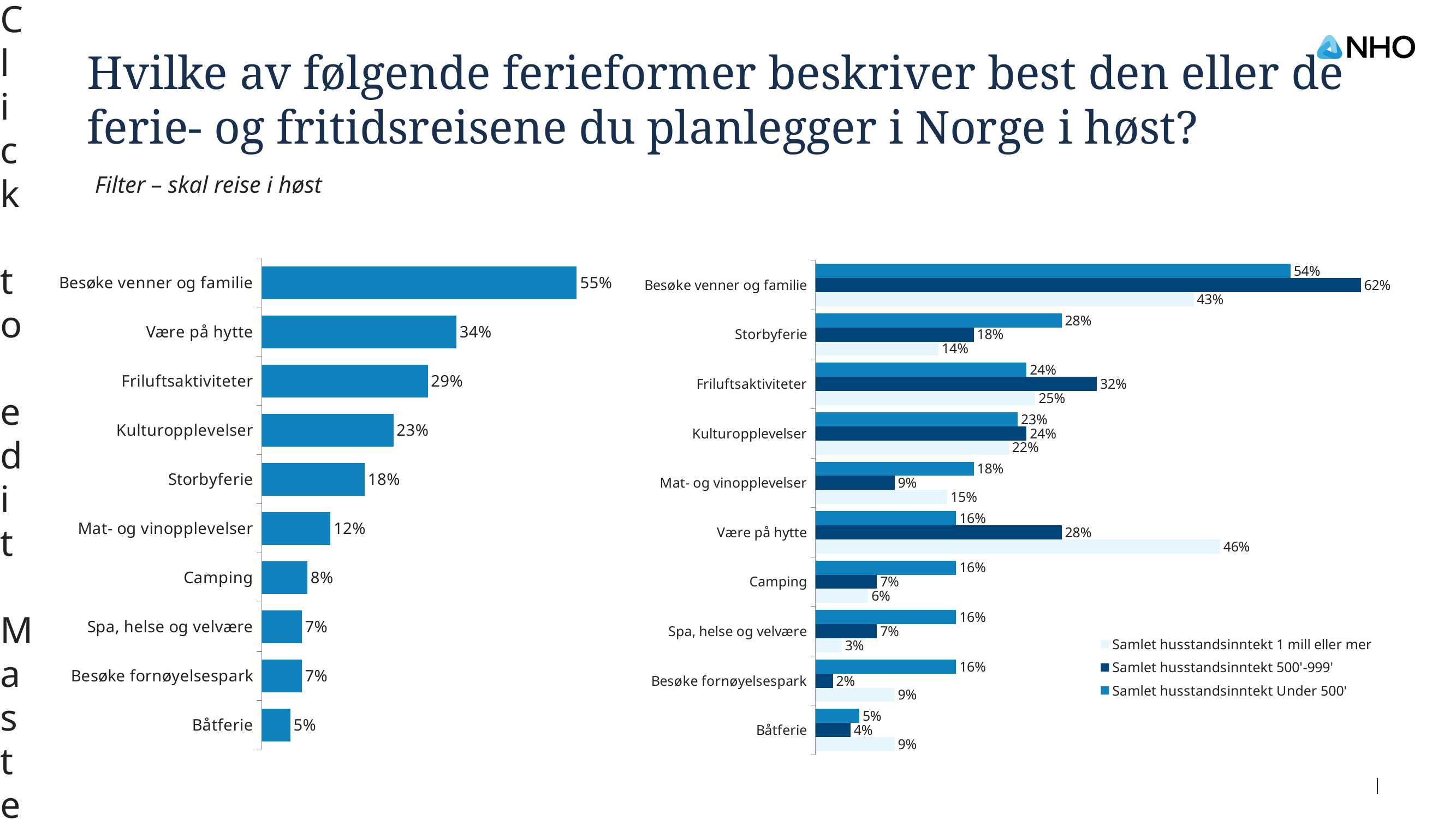
How many series does the legend of the right chart list? 3 In the right chart, what is the value for Besøke venner og familie in the series Samlet husstandsinntekt 500'-999'? 62% In the left chart, which category has the lowest value? Båtferie In the right chart, what is the value for Være på hytte in the series Samlet husstandsinntekt 1 mill eller mer? 46% In the left chart, what is the difference between Friluftsaktiviteter and Kulturopplevelser? 6 percentage points In the right chart, which series is shown in the darkest blue? Samlet husstandsinntekt 500'-999' In the right chart, what is the difference between Samlet husstandsinntekt Under 500' and Samlet husstandsinntekt 500'-999' for Besøke fornøyelsespark? 14 percentage points What kind of chart is the left chart? Bar chart In the left chart, what is the value for Være på hytte? 34% How many categories does the left chart show? 10 In the right chart, which is larger for Storbyferie: Samlet husstandsinntekt Under 500' or Samlet husstandsinntekt 1 mill eller mer? Samlet husstandsinntekt Under 500' In the left chart, which category has the highest value? Besøke venner og familie